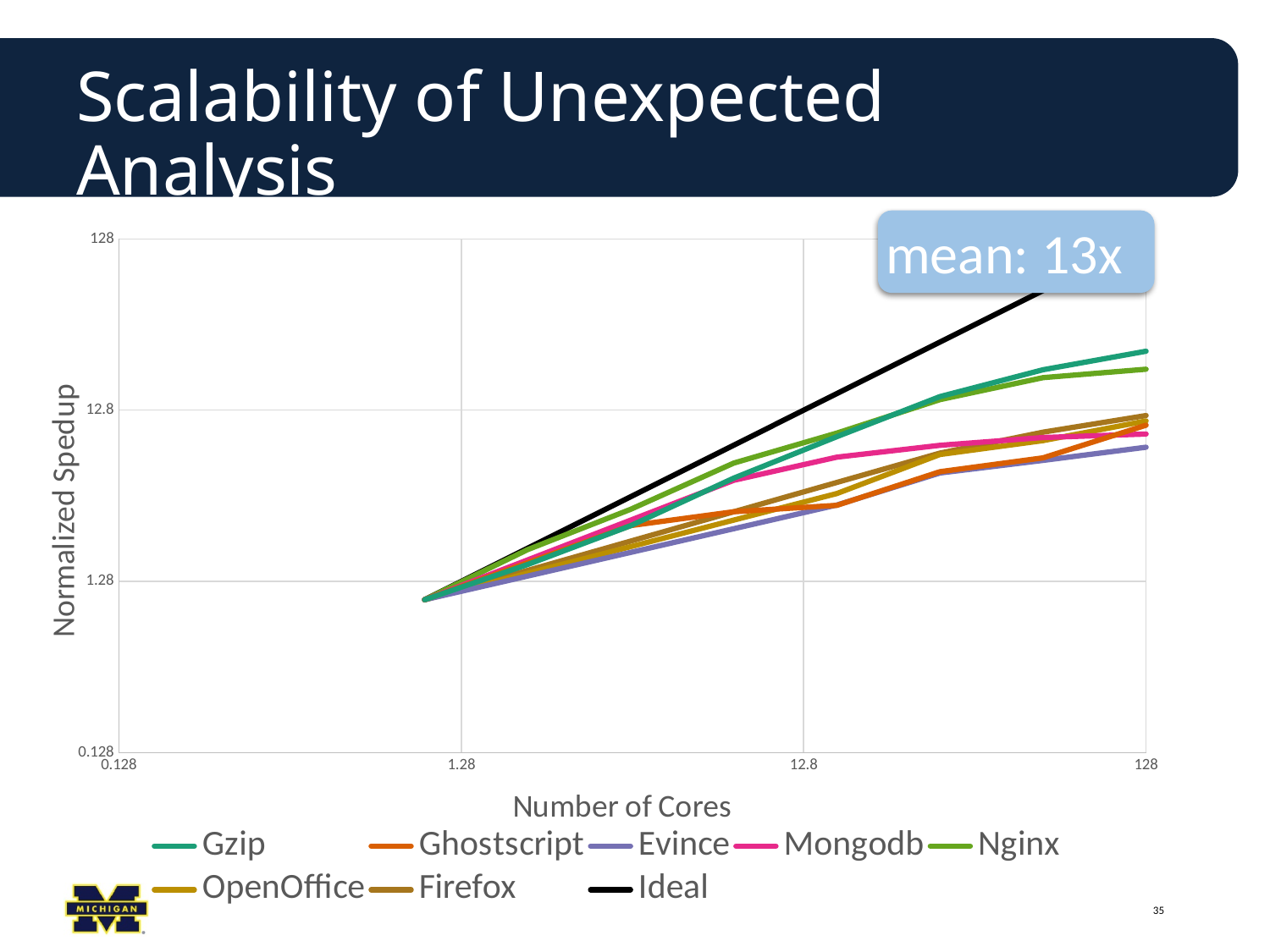
Does the normalized speedup for Gzip rise or fall as the number of cores increases? rise What kind of chart is shown on the slide? line chart Which series has the highest normalized speedup at 128 cores? Ideal How many series does the legend list? 8 Which series has the lowest normalized speedup at 128 cores? Evince Is the normalized speedup for Gzip at 128 cores greater or less than 12.8? greater At 128 cores, which has the higher normalized speedup, Ideal or Gzip? Ideal What is the label of the y axis? Normalized Spedup At 128 cores, which has the higher normalized speedup, Gzip or Evince? Gzip What is the label of the x axis? Number of Cores Is the normalized speedup for Evince at 128 cores greater or less than 12.8? less Is the normalized speedup for Ideal at 128 cores greater or less than 12.8? greater